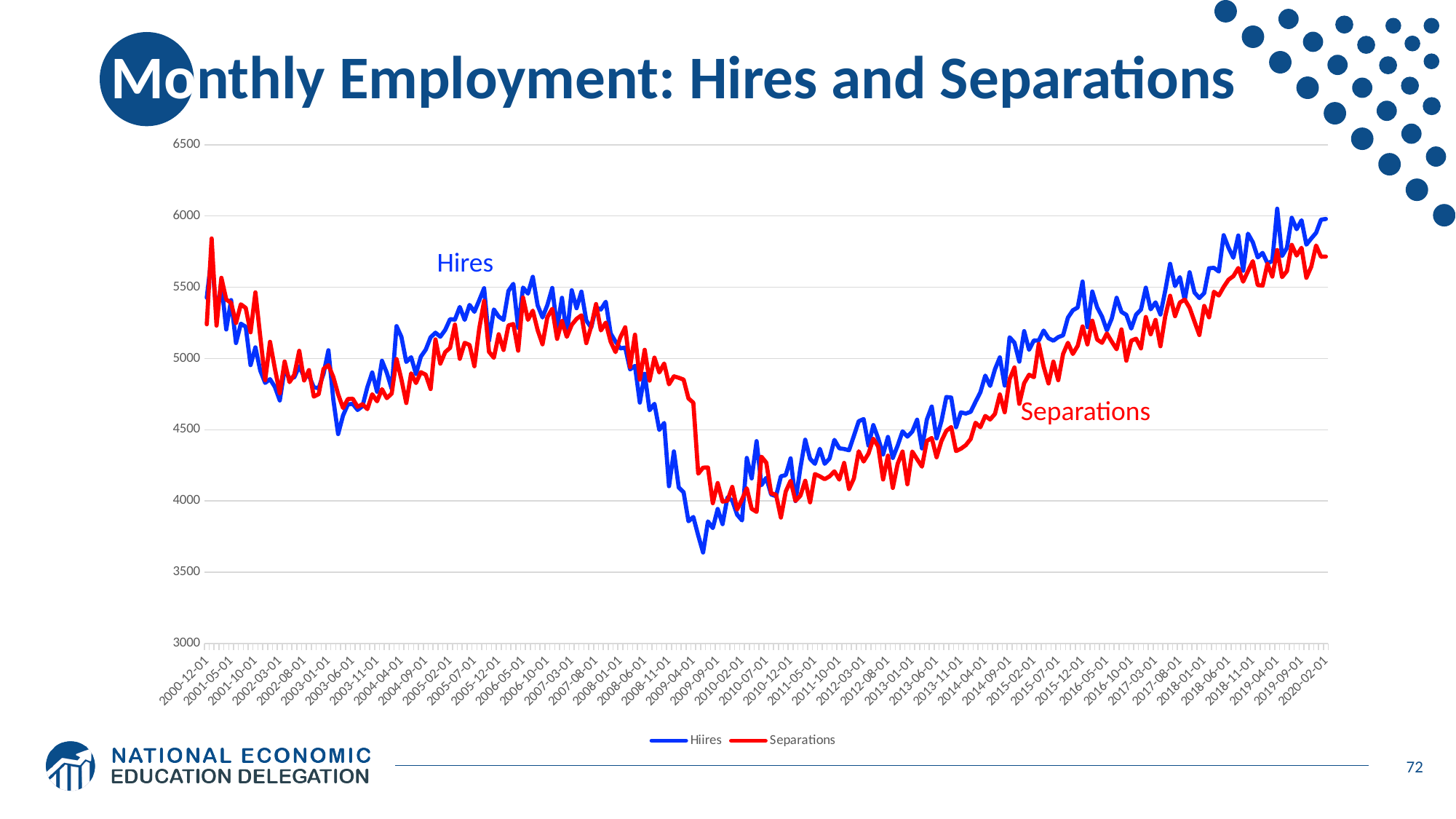
Is the value for Hires at 2020-02-01 greater or less than 5500? greater Is the value for Separations at 2011-05-01 greater or less than 4500? less Do the Hires values rise or fall between 2009-09-01 and 2020-02-01? rise Is the value for Hires at 2000-12-01 greater or less than 5000? greater Which colour is used for the Separations series? red How many series does the legend list? 2 At 2009-04-01, which series has the higher value, Hires or Separations? Separations What is the title of the chart on the slide? Monthly Employment: Hires and Separations In which year does the Hires series reach its lowest point? 2009 What kind of chart is shown on the slide? line chart